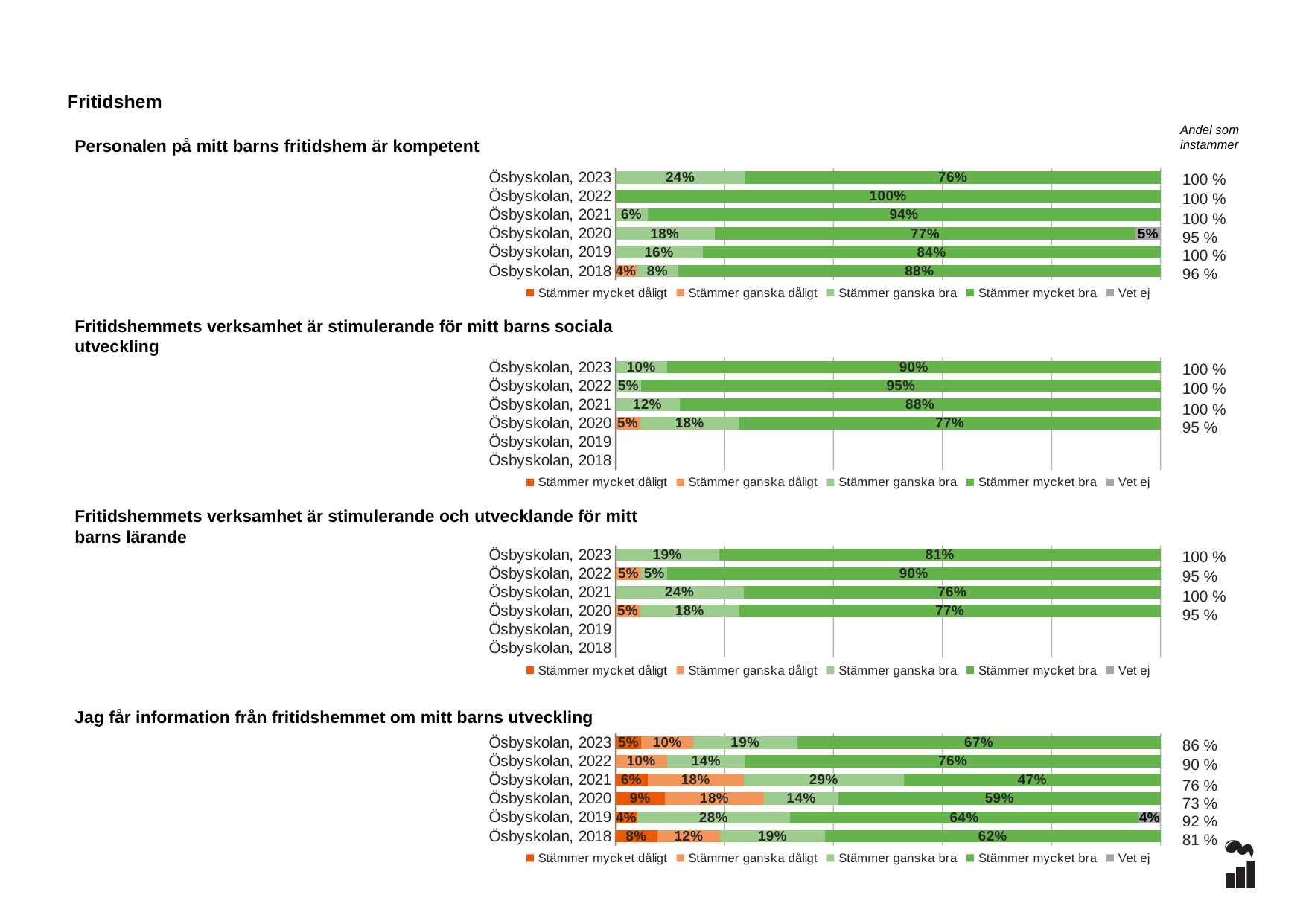
In the chart 'Jag får information från fritidshemmet om mitt barns utveckling', what is the 'Stämmer mycket dåligt' value for Ösbyskolan, 2020? 9% In the chart 'Fritidshemmets verksamhet är stimulerande och utvecklande för mitt barns lärande', what is the 'Stämmer ganska dåligt' value for Ösbyskolan, 2022? 5% In the chart 'Personalen på mitt barns fritidshem är kompetent', what is the difference between the 'Stämmer mycket bra' values for Ösbyskolan, 2018 and Ösbyskolan, 2023? 12% In the chart 'Personalen på mitt barns fritidshem är kompetent', which year has the highest 'Stämmer mycket bra' value? Ösbyskolan, 2022 In the chart 'Personalen på mitt barns fritidshem är kompetent', what is the 'Stämmer mycket bra' value for Ösbyskolan, 2021? 94% What kind of chart is 'Personalen på mitt barns fritidshem är kompetent'? Stacked bar chart In the chart 'Personalen på mitt barns fritidshem är kompetent', what is the 'Vet ej' value for Ösbyskolan, 2020? 5% In the chart 'Jag får information från fritidshemmet om mitt barns utveckling', which year has the lowest 'Stämmer mycket bra' value? Ösbyskolan, 2021 How many series does the legend list in the chart 'Jag får information från fritidshemmet om mitt barns utveckling'? 5 In the chart 'Fritidshemmets verksamhet är stimulerande för mitt barns sociala utveckling', which year has the lowest 'Stämmer mycket bra' value among the years with data? Ösbyskolan, 2020 In the chart 'Fritidshemmets verksamhet är stimulerande för mitt barns sociala utveckling', what is the 'Stämmer ganska bra' value for Ösbyskolan, 2021? 12% In the chart 'Fritidshemmets verksamhet är stimulerande och utvecklande för mitt barns lärande', is the 'Stämmer mycket bra' value larger for Ösbyskolan, 2023 or Ösbyskolan, 2021? Ösbyskolan, 2023